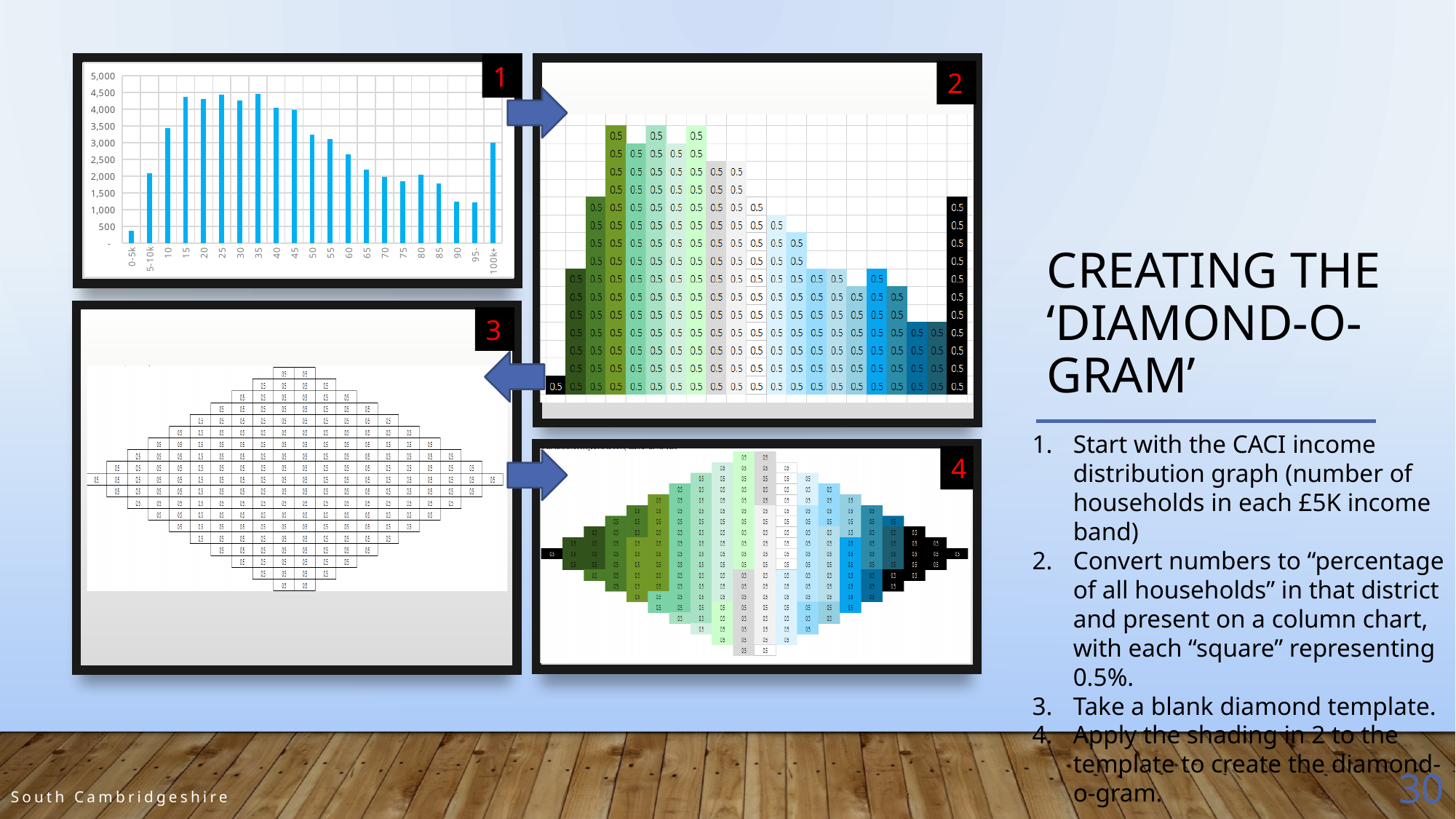
In chart 1 (top left), do the values rise or fall along the x axis from 35 to 95-? fall In chart 1 (top left), is the value for 100k+ greater or less than 3,500? less In chart 1 (top left), is the value for 15 greater or less than 4,000? greater What kind of chart is chart 1 (top left)? bar chart In chart 1 (top left), is the value for 0-5k greater or less than 500? less In chart 1 (top left), how many income band categories are shown on the x axis? 21 In chart 1 (top left), which has the larger value, 10 or 100k+? 10 In chart 2 (top right), what value is printed in each shaded square? 0.5 In chart 1 (top left), which has the larger value, 5-10k or 60? 60 In chart 1 (top left), which income band has the lowest value? 0-5k